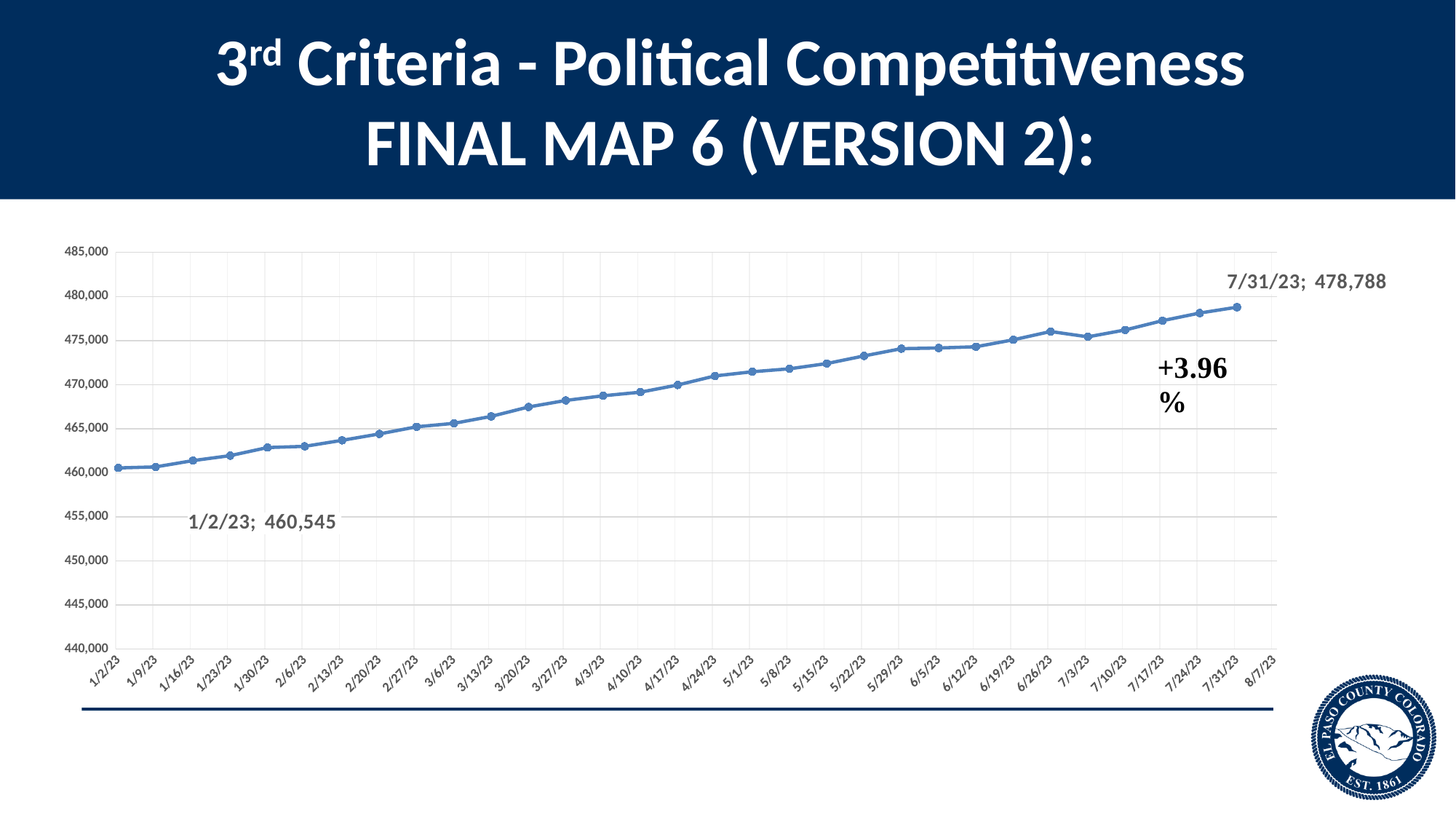
Is the value for 2/6/23 greater or less than 465,000? less Which date has the highest value on the chart? 7/31/23 What is the value labelled for 7/31/23? 478,788 Is the value for 7/3/23 greater or less than 480,000? less Which is larger, the value for 7/31/23 or the value for 1/2/23? 7/31/23 What kind of chart is shown on the slide? line chart What percentage change is annotated on the chart? +3.96% What is the value labelled for 1/2/23? 460,545 What is the difference between the labelled values for 7/31/23 and 1/2/23? 18,243 Do the values generally rise or fall from 1/2/23 to 7/31/23? rise Is the value for 5/1/23 greater or less than 470,000? greater How many data points are plotted on the line? 31